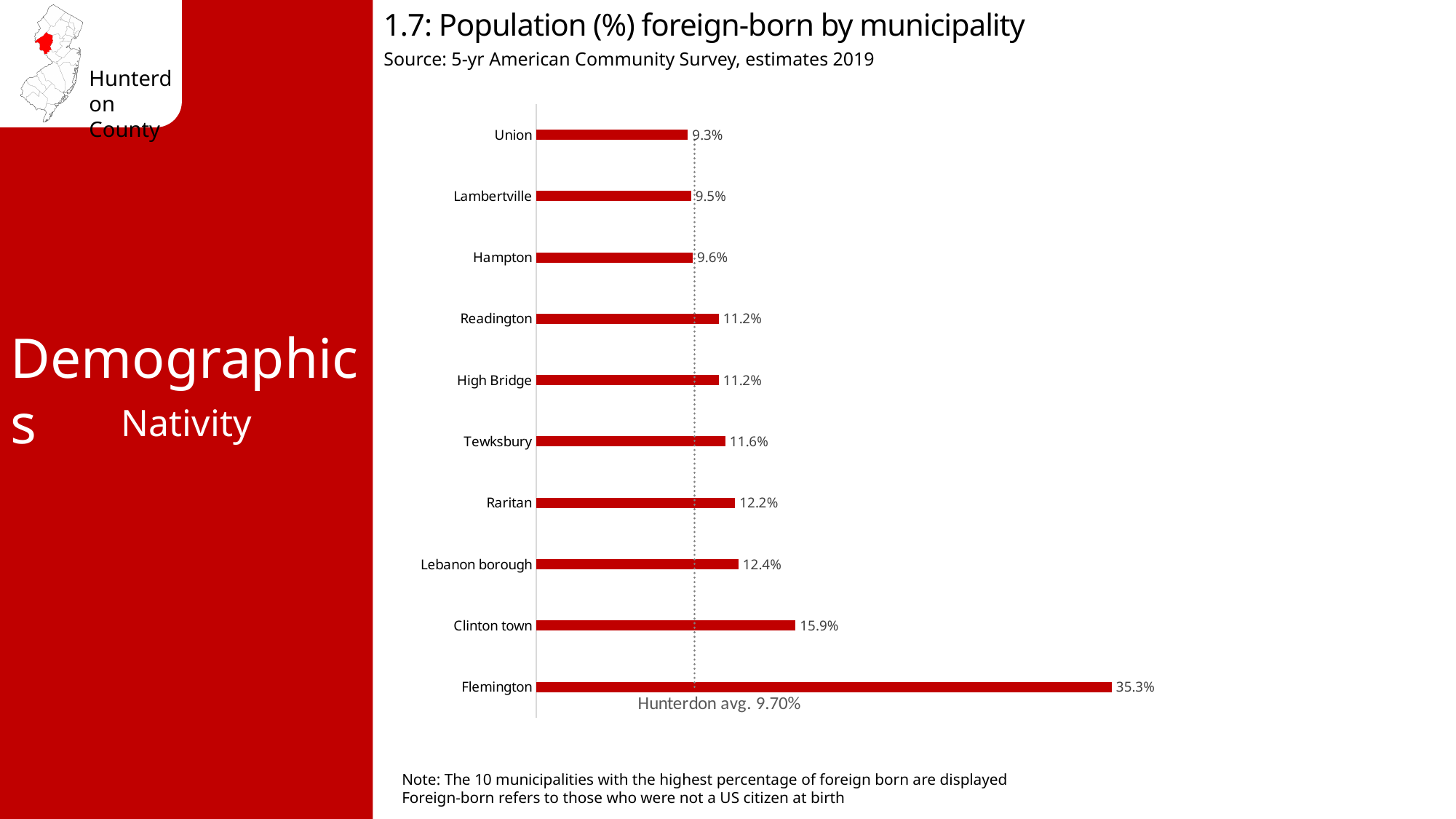
What is the difference in foreign-born percentage between Lebanon borough and Raritan? 0.2% How many municipalities are shown in the chart? 10 What type of chart is used on this slide? Bar chart What is the foreign-born population percentage for Flemington? 35.3% What is the foreign-born population percentage for Tewksbury? 11.6% What is the foreign-born population percentage for Clinton town? 15.9% Which has a higher foreign-born percentage, Hampton or Readington? Readington What Hunterdon average value is marked by the dotted line on the chart? 9.70% What is the foreign-born population percentage for Lambertville? 9.5% Which municipality has the lowest foreign-born population percentage shown? Union What is the difference in foreign-born percentage between Flemington and Clinton town? 19.4% Which municipality has the highest foreign-born population percentage? Flemington